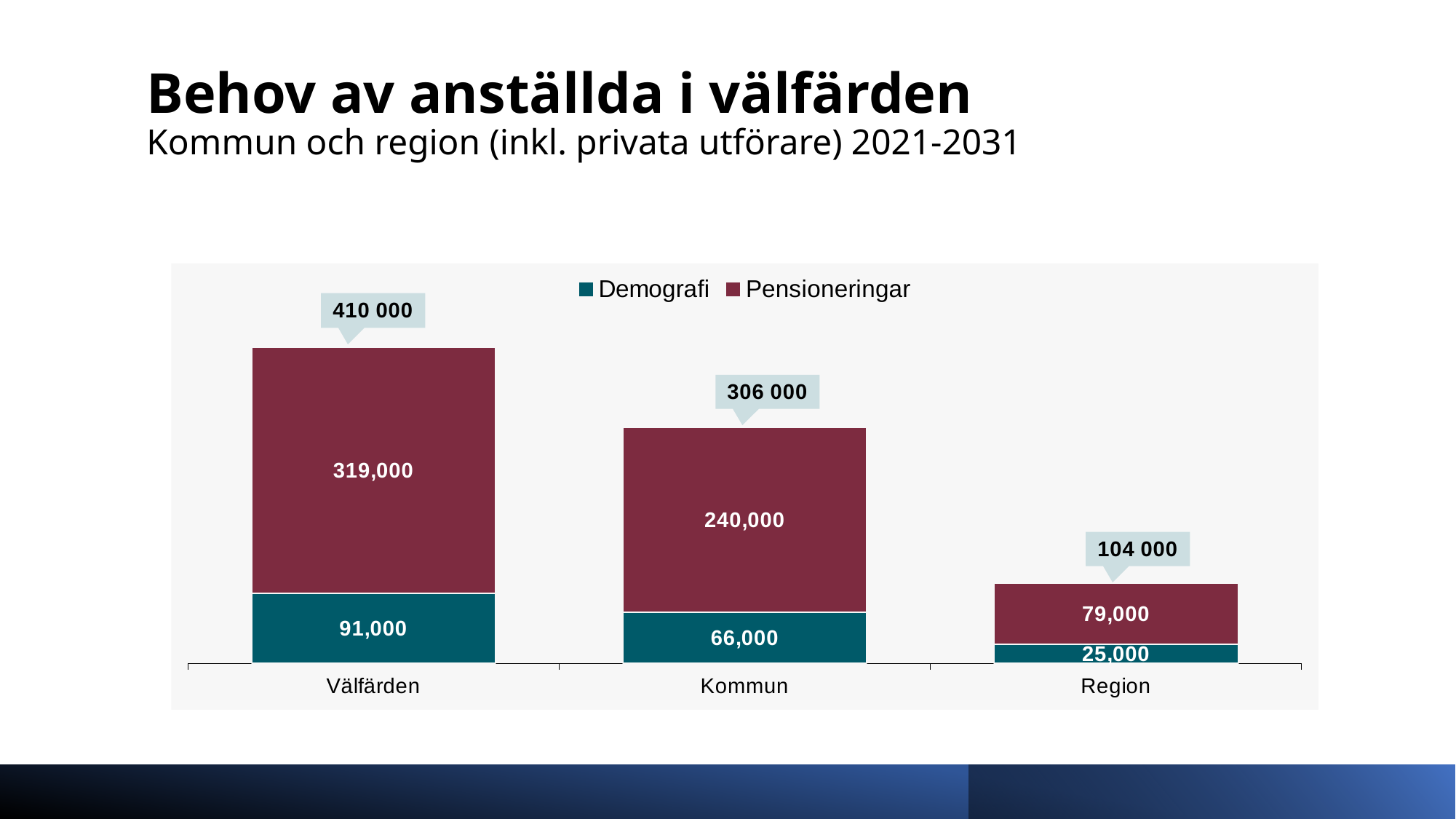
Which is larger: the Demografi value for Kommun or the Pensioneringar value for Region? Pensioneringar for Region What is the Pensioneringar value for Region? 79,000 What is the Demografi value for Region? 25,000 How many categories are shown on the x axis? 3 How many series does the legend list? 2 Which category has the highest total? Välfärden What is the Pensioneringar value for Kommun? 240,000 What is the total of the stacked bar for Kommun? 306 000 What is the Demografi value for Välfärden? 91,000 Which category has the lowest Demografi value? Region What is the difference between the Pensioneringar values for Välfärden and Kommun? 79,000 What is the total of the stacked bar for Region? 104 000